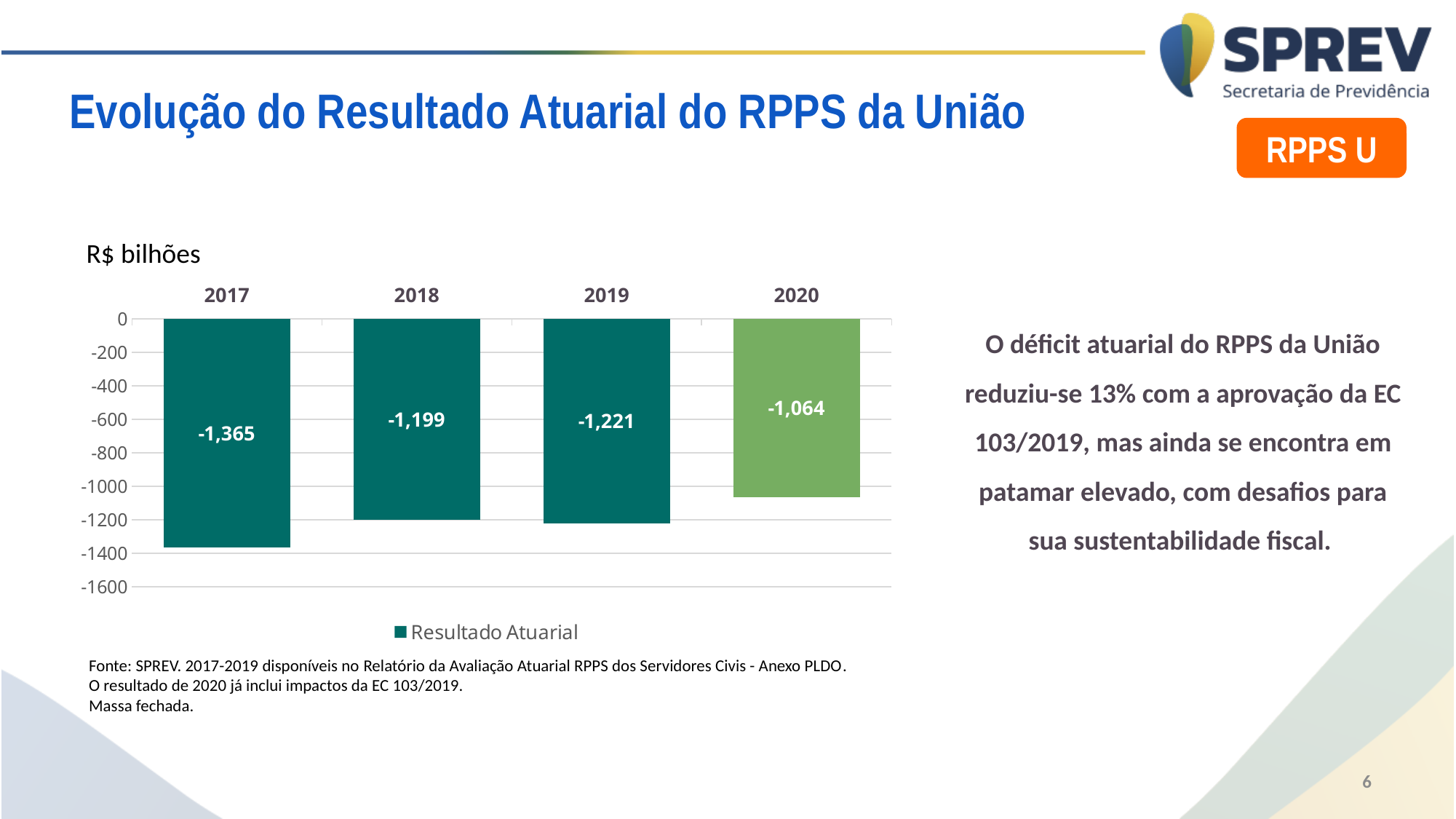
Which is larger, the Resultado Atuarial value for 2018 or for 2019? 2018 How many years are shown on the x axis of the chart? 4 What is the difference between the 2017 value (-1,365) and the 2020 value (-1,064)? 301 Which year has the lowest (most negative) Resultado Atuarial value? 2017 Which year has the highest (least negative) Resultado Atuarial value? 2020 What is the Resultado Atuarial value for 2018? -1,199 What is the difference between the 2019 value (-1,221) and the 2018 value (-1,199)? 22 What series name does the chart legend show? Resultado Atuarial Is the value for 2020 greater or less than -1000? less What is the Resultado Atuarial value for 2017? -1,365 What is the Resultado Atuarial value for 2020? -1,064 What kind of chart is shown on the slide? bar chart